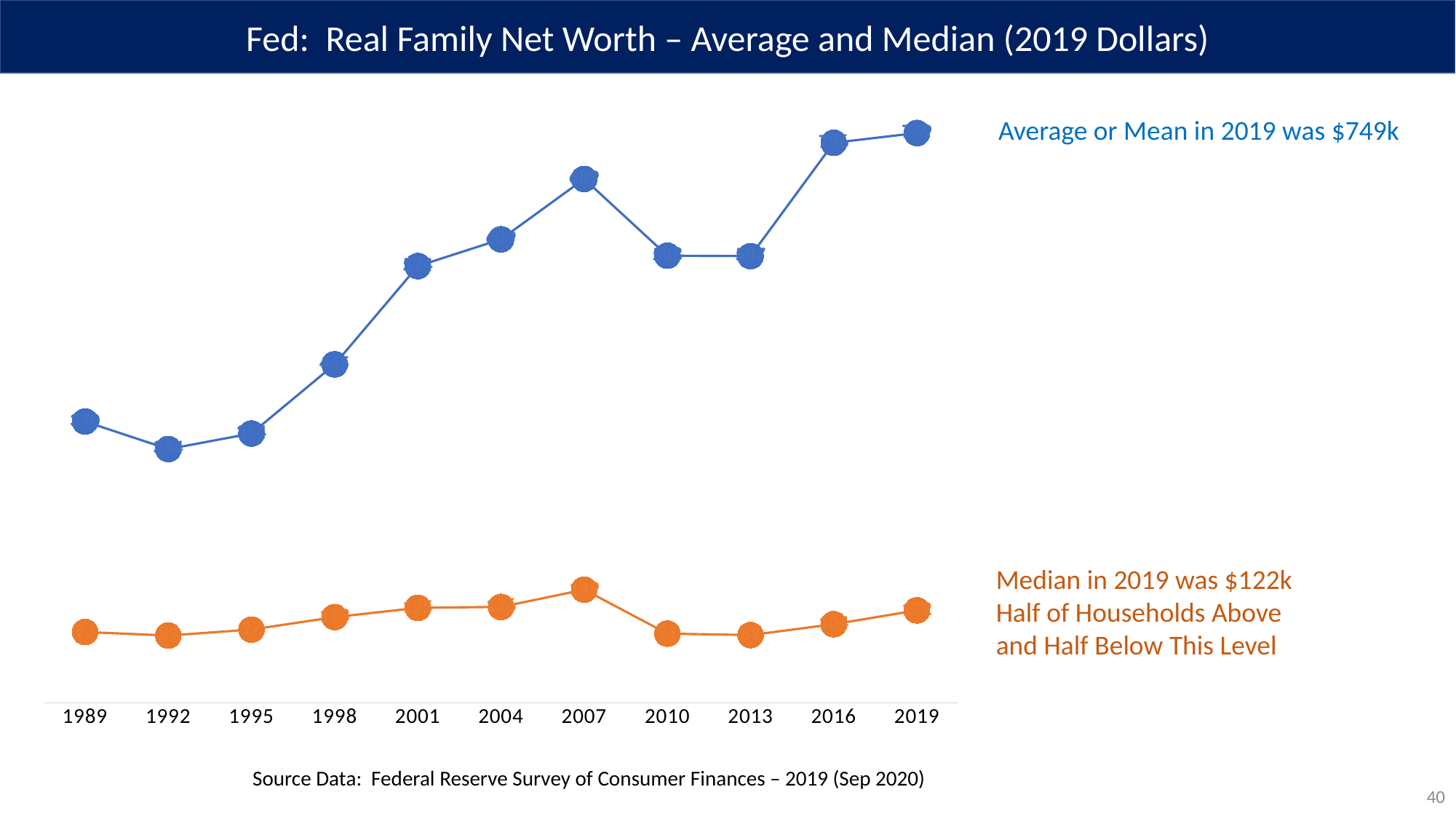
What was the median real family net worth in 2019 according to the slide? $122k In 2019, which is larger: the average or the median real family net worth? Average For the average (blue) series, is the value in 2007 higher or lower than the value in 2013? Higher What kind of chart is shown on the slide? Line chart What is the difference between the average and the median real family net worth in 2019? $627k How many data series (lines) are plotted on the chart? 2 What was the average (mean) real family net worth in 2019 according to the slide? $749k Does the median (orange) series rise or fall between 2007 and 2010? Fall How many years are plotted along the x axis of the chart? 11 In which year does the median (orange) series reach its highest point? 2007 In which year is the average (blue) series at its lowest point? 1992 What colour is the line representing the median series? Orange